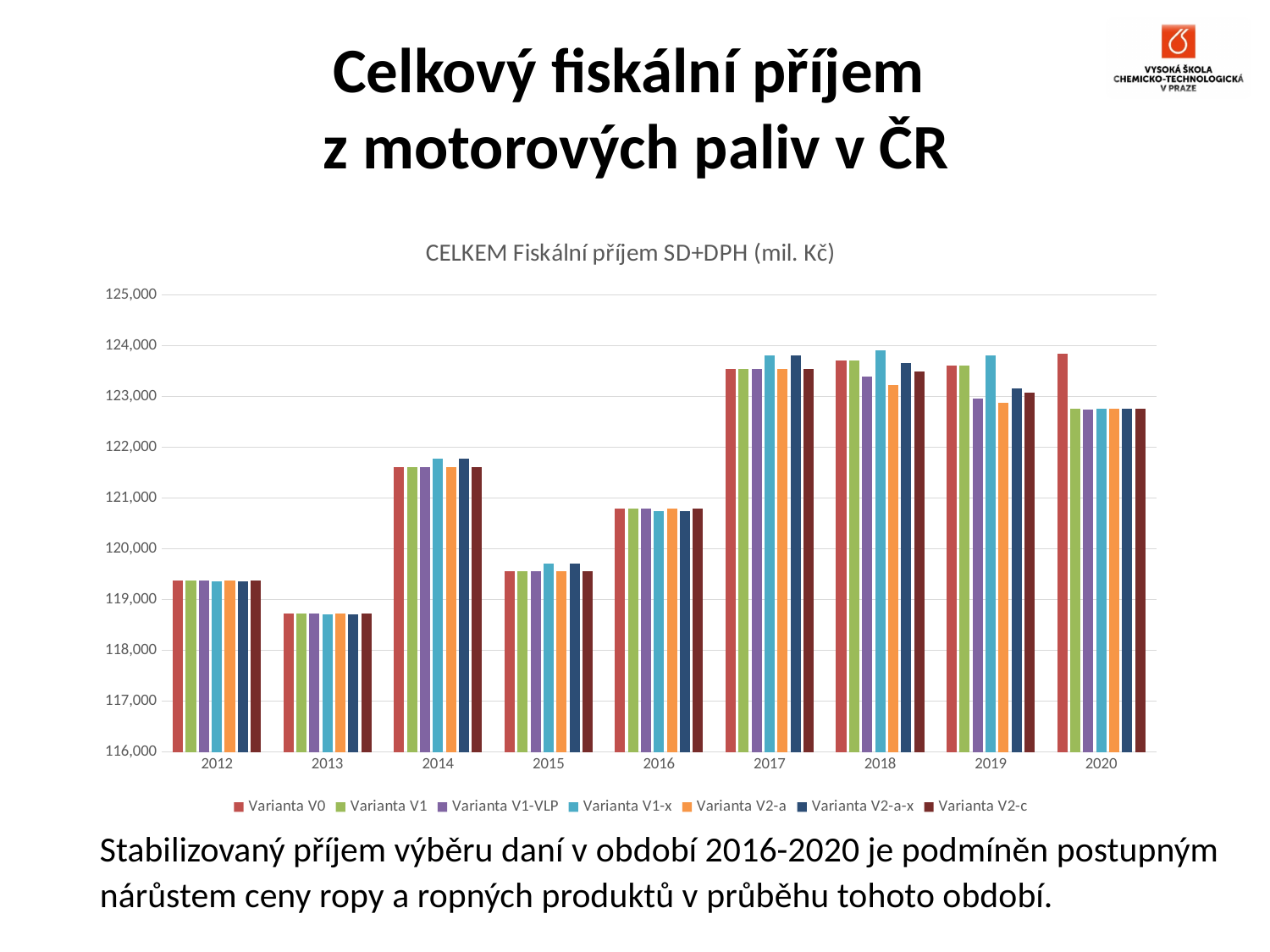
Is the value for Varianta V0 in 2012 greater or less than 119,000? greater Is the value for Varianta V1-x in 2017 greater or less than 123,000? greater In 2019, which variant has the highest value? Varianta V1-x How many series does the chart legend list? 7 Is the value for Varianta V2-c in 2015 greater or less than 120,000? less Which is larger for Varianta V0: the value in 2013 or the value in 2014? 2014 What kind of chart is shown on the slide? bar chart Which year has the lowest values across all variants? 2013 What is the title of the chart? CELKEM Fiskální příjem SD+DPH (mil. Kč) Do the values rise or fall from 2013 to 2014? rise How many years are shown on the x axis of the chart? 9